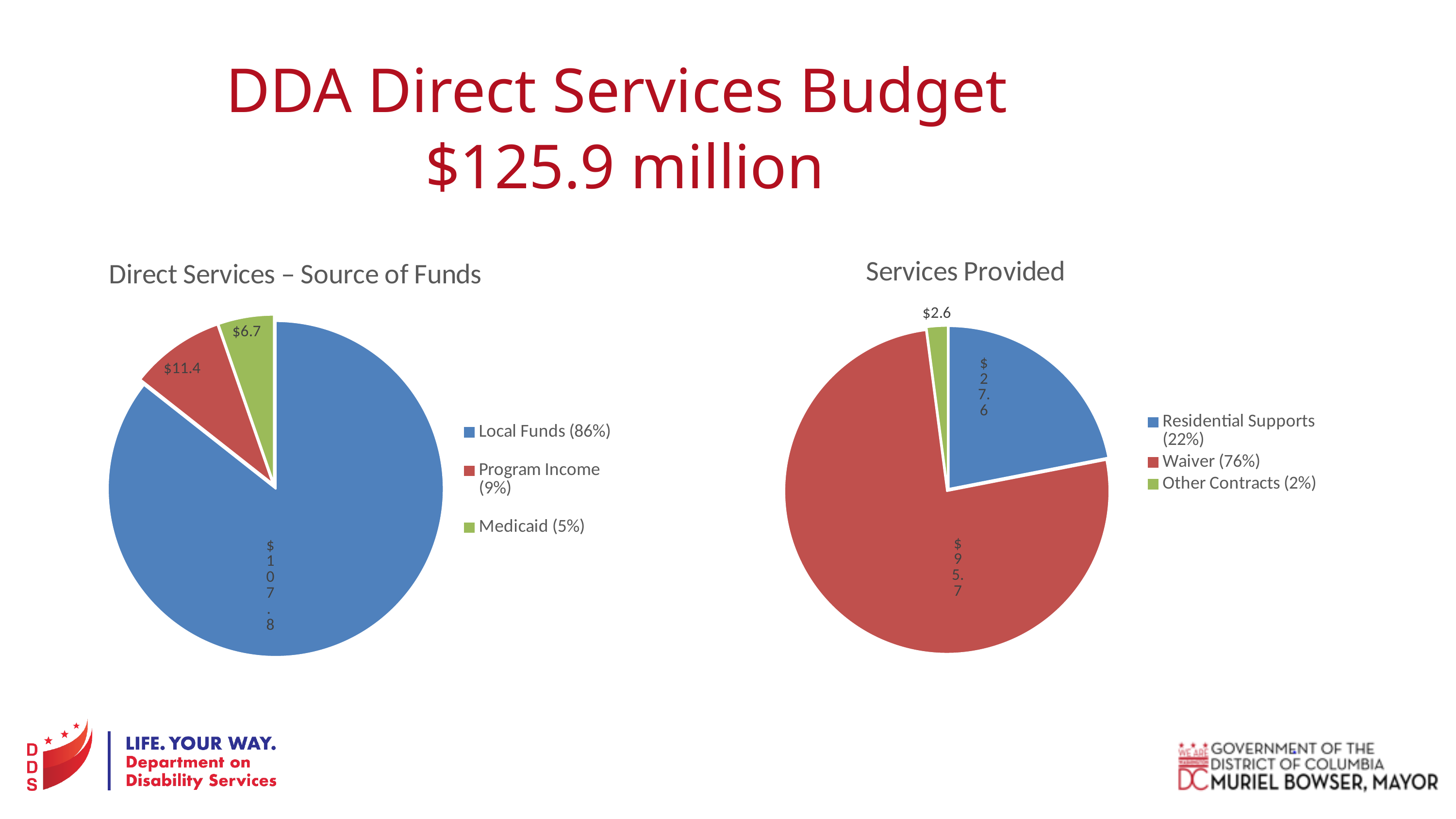
In the 'Direct Services – Source of Funds' chart, what share of the pie does Medicaid represent? 5% In the 'Services Provided' chart, which category is the smallest? Other Contracts In the 'Direct Services – Source of Funds' chart, which category is the largest? Local Funds In the 'Services Provided' chart, what share of the pie does Waiver represent? 76% In the 'Direct Services – Source of Funds' chart, what is the value for Medicaid? $6.7 In the 'Direct Services – Source of Funds' chart, what is the difference between Program Income and Medicaid? $4.7 In the 'Services Provided' chart, what is the value for Waiver? $95.7 What type of chart is the 'Services Provided' chart? Pie chart In the 'Services Provided' chart, what is the value for Residential Supports? $27.6 In the 'Direct Services – Source of Funds' chart, what is the value for Local Funds? $107.8 In the 'Direct Services – Source of Funds' chart, what is the value for Program Income? $11.4 In the 'Services Provided' chart, which is larger, Residential Supports or Other Contracts? Residential Supports